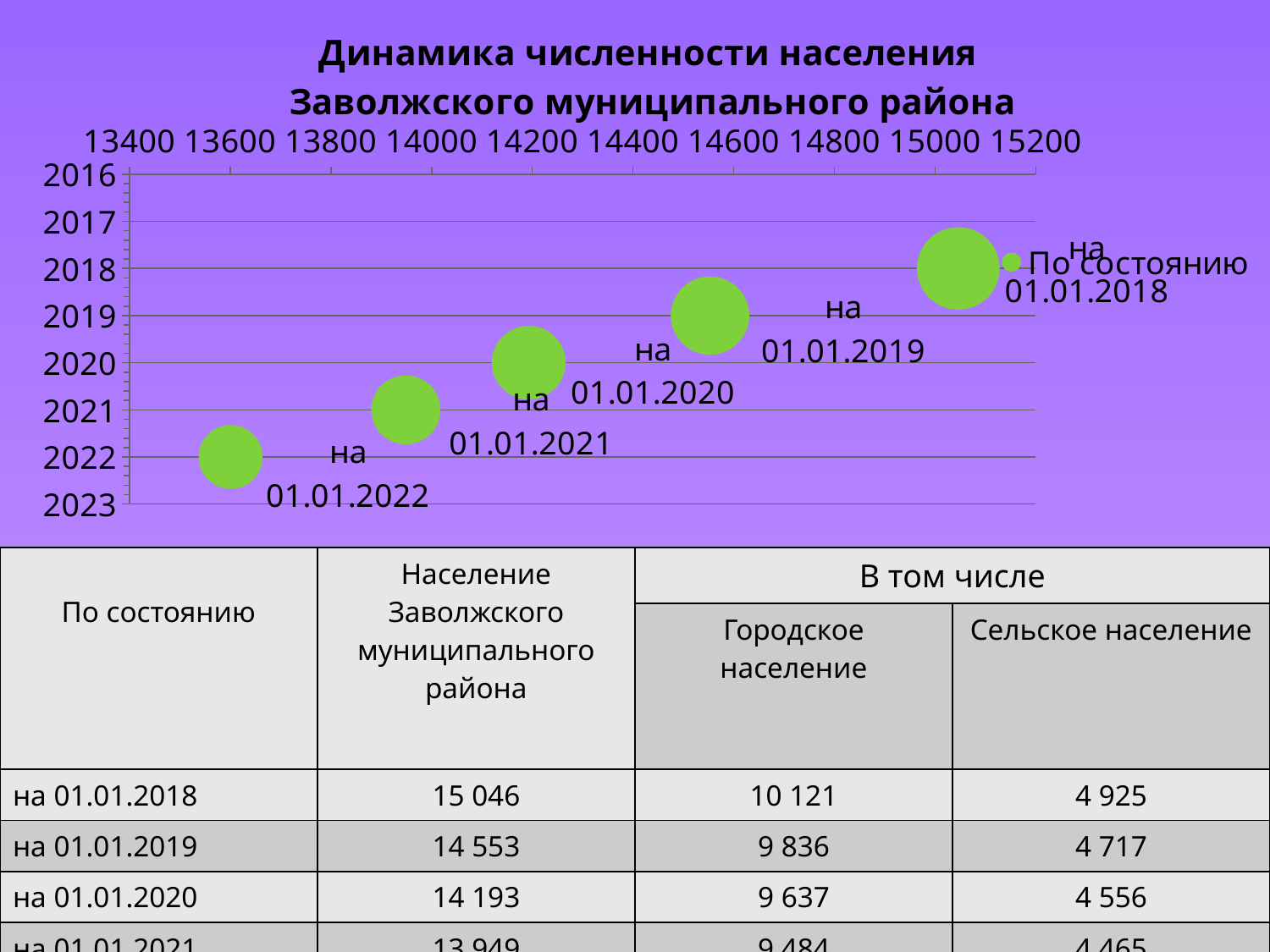
Do the population values rise or fall from 01.01.2018 to 01.01.2022? fall What is the legend entry of the chart? По состоянию What kind of chart is shown on the slide? bubble chart What is the title of the chart? Динамика численности населения Заволжского муниципального района How many bubbles (data points) are plotted on the chart? 5 How many series does the chart legend list? 1 Which date has the lowest population value on the chart? на 01.01.2022 Which is larger, the value for на 01.01.2020 or the value for на 01.01.2021? на 01.01.2020 Is the value for на 01.01.2022 greater or less than 13800? less Which date has the highest population value on the chart? на 01.01.2018 Is the value for на 01.01.2018 greater or less than 15000? greater Is the value for на 01.01.2019 greater or less than 14400? greater